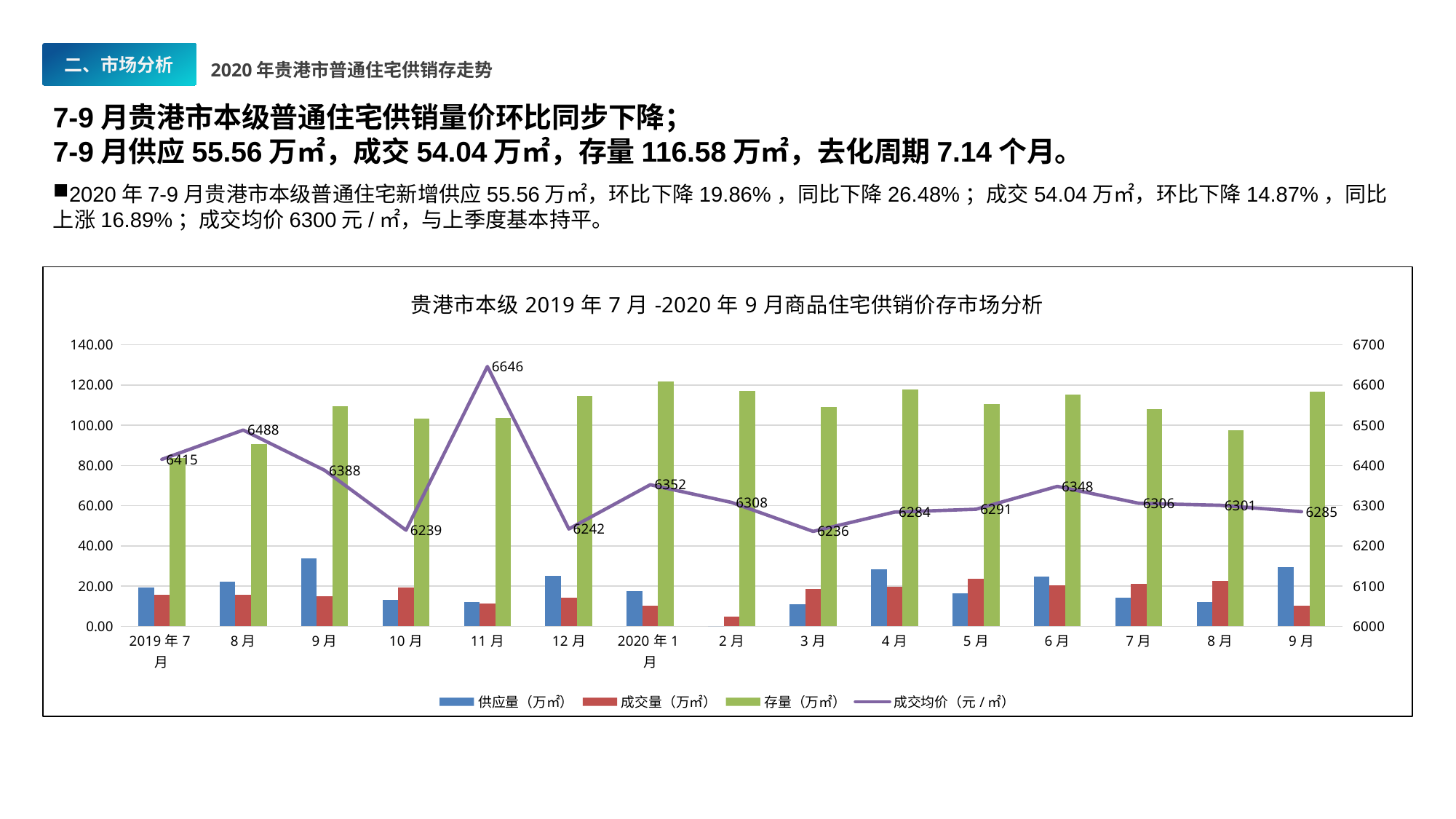
What is the 成交均价 (元/㎡) value for 11月 (2019)? 6646 How many series does the legend list? 4 Which is larger, the 成交均价 for 8月 (2019) or for 8月 (2020)? 8月 (2019) Which month has the lowest 成交均价 (元/㎡)? 3月 (2020) Which month has the highest 成交均价 (元/㎡)? 11月 (2019) What is the difference in 成交均价 between 11月 (2019) and 10月 (2019)? 407 What is the 成交均价 (元/㎡) value for 2019年7月? 6415 How many months are shown on the x axis? 15 Is the 存量 (万㎡) value for 2020年1月 greater or less than 100.00? greater What kind of chart is this? Combined bar and line chart Is the 供应量 (万㎡) value for 9月 (2019) greater or less than 40.00? less What is the 成交均价 (元/㎡) value for 9月 (2020)? 6285